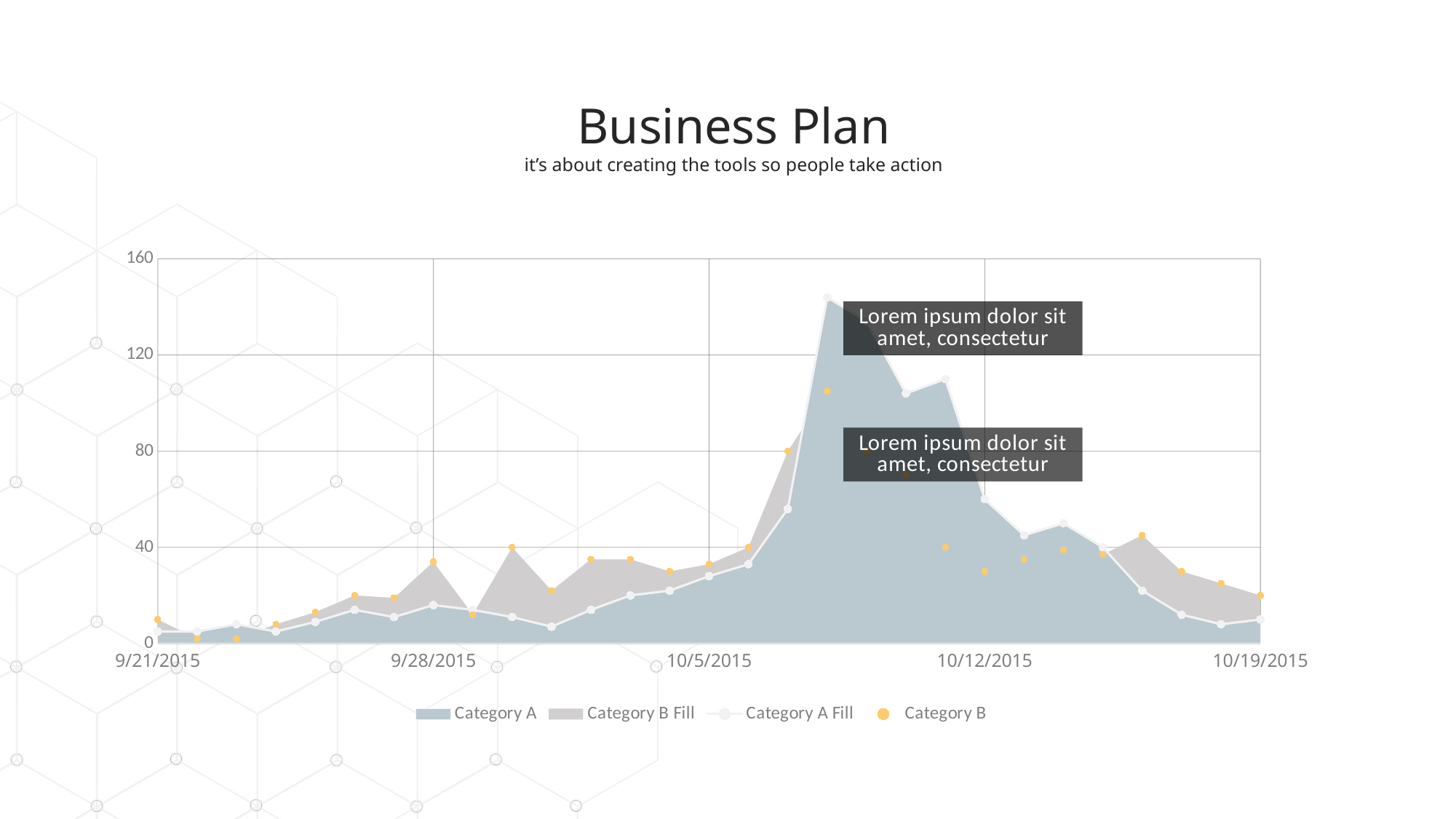
How many series does the chart legend list? 4 How many date labels are shown on the x axis? 5 Does the Category A Fill line rise or fall between 10/12/2015 and 10/19/2015? fall What kind of chart is shown on the slide? area chart Is the highest value of the Category A Fill line greater or less than 120? greater Is the value of Category A Fill at 10/5/2015 greater or less than 40? less Is the Category A Fill value higher at 10/12/2015 or at 10/19/2015? 10/12/2015 Is the value of Category A Fill at 10/19/2015 greater or less than 40? less What is the title of the slide containing the chart? Business Plan Which series is shown as yellow dots in the legend? Category B